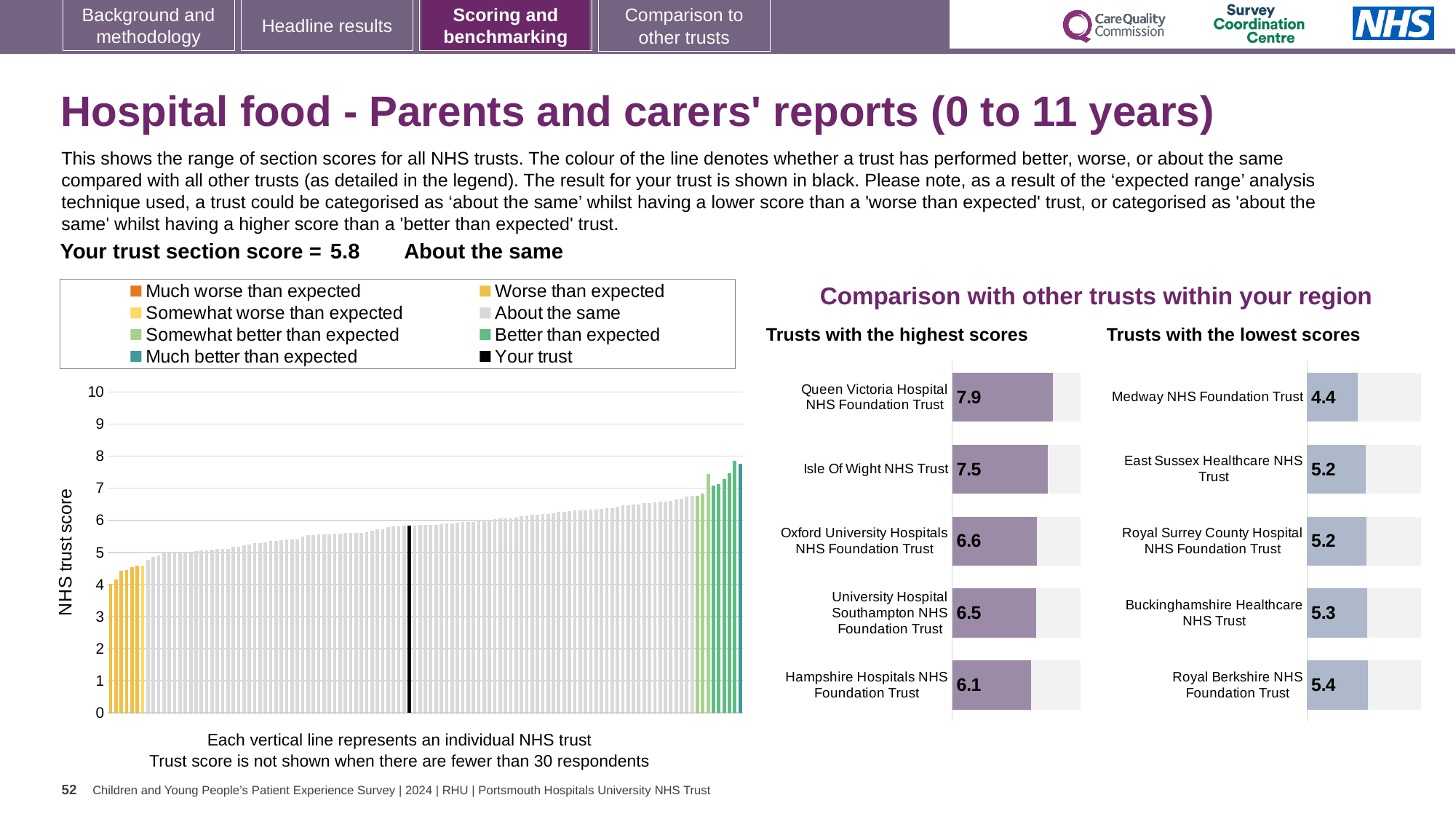
In the 'Trusts with the highest scores' chart, which trust has the lowest score? Hampshire Hospitals NHS Foundation Trust In the 'Trusts with the lowest scores' chart, which has the higher score: Buckinghamshire Healthcare NHS Trust or Medway NHS Foundation Trust? Buckinghamshire Healthcare NHS Trust In the 'Trusts with the highest scores' chart, what is the score for Queen Victoria Hospital NHS Foundation Trust? 7.9 In the large chart on the left showing NHS trust scores, do the values rise or fall from left to right? Rise In the 'Trusts with the lowest scores' chart, how many trusts are shown? 5 In the 'Trusts with the lowest scores' chart, which trust has the highest score? Royal Berkshire NHS Foundation Trust In the 'Trusts with the lowest scores' chart, what is the score for Medway NHS Foundation Trust? 4.4 In the 'Trusts with the lowest scores' chart, what is the difference between the scores of Royal Berkshire NHS Foundation Trust and Medway NHS Foundation Trust? 1.0 In the large chart on the left showing NHS trust scores, what kind of chart is it? Bar chart In the 'Trusts with the highest scores' chart, what is the score for Oxford University Hospitals NHS Foundation Trust? 6.6 In the large chart on the left showing NHS trust scores, is the value for the black bar (your trust) greater or less than 5? greater In the 'Trusts with the highest scores' chart, what is the difference between the scores of Queen Victoria Hospital NHS Foundation Trust and Isle Of Wight NHS Trust? 0.4